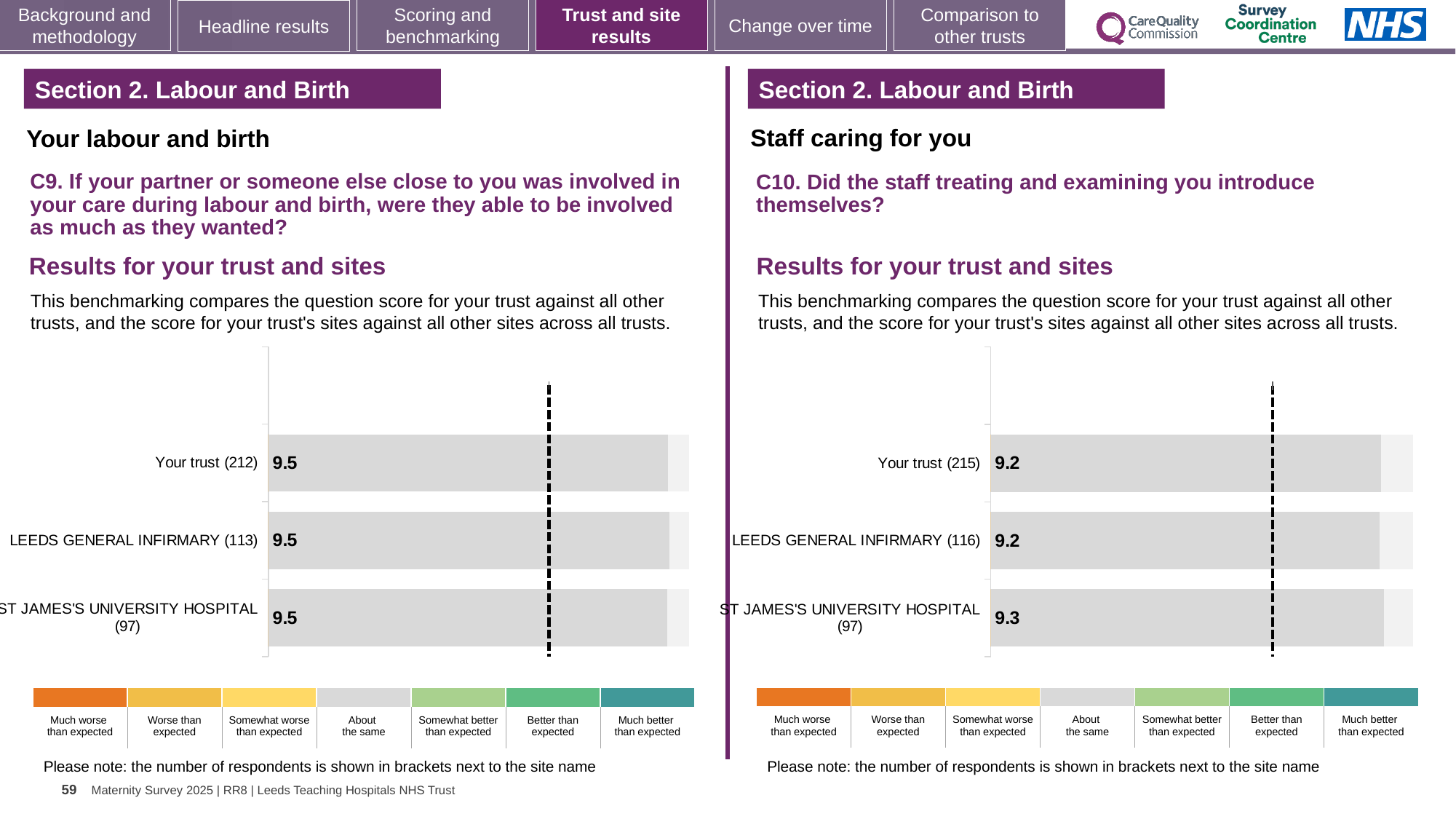
In the C10 chart on the right, what is the score for Your trust (215)? 9.2 How many categories does the colour legend below the C9 chart on the left list? 7 In the C9 chart on the left, what is the score for LEEDS GENERAL INFIRMARY (113)? 9.5 What kind of chart is used for the C10 results on the right? Bar chart In the C10 chart on the right, which is larger: the score for ST JAMES'S UNIVERSITY HOSPITAL (97) or the score for LEEDS GENERAL INFIRMARY (116)? ST JAMES'S UNIVERSITY HOSPITAL (97) In the C10 chart on the right, what is the difference between the score for ST JAMES'S UNIVERSITY HOSPITAL (97) and the score for Your trust (215)? 0.1 In the C9 chart on the left, what is the score for Your trust (212)? 9.5 In the C10 chart on the right, what is the score for ST JAMES'S UNIVERSITY HOSPITAL (97)? 9.3 How many bars are shown in the C9 chart on the left? 3 In the C10 chart on the right, which site or trust has the highest score? ST JAMES'S UNIVERSITY HOSPITAL (97) In the C10 chart on the right, what is the score for LEEDS GENERAL INFIRMARY (116)? 9.2 In the C9 chart on the left, do all three bars show the same score? Yes